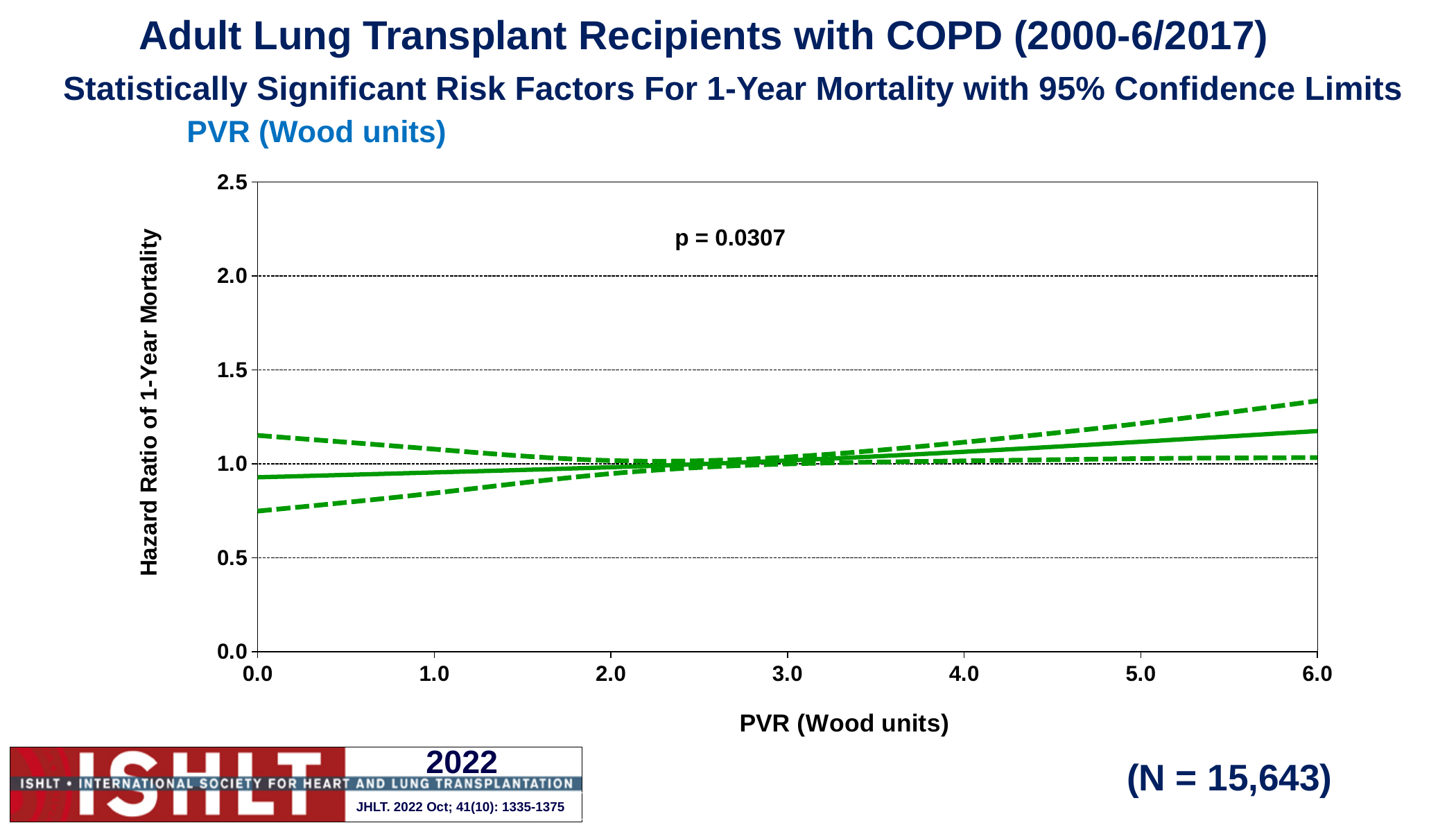
What p-value is printed on the chart? p = 0.0307 Is the upper dashed confidence limit at a PVR of 6.0 Wood units greater or less than 1.5? less Is the solid hazard ratio line higher at a PVR of 6.0 or at a PVR of 0.0 Wood units? 6.0 Is the hazard ratio shown by the solid line at a PVR of 6.0 Wood units greater or less than 1.0? greater What is the label of the x axis of the chart? PVR (Wood units) What kind of chart is shown on the slide? line chart What is the highest value shown on the y axis of the chart? 2.5 Is the hazard ratio shown by the solid line at a PVR of 0.0 Wood units greater or less than 1.0? less How many lines are plotted on the chart? 3 Does the solid hazard ratio line rise or fall as PVR increases from 0.0 to 6.0 Wood units? rise